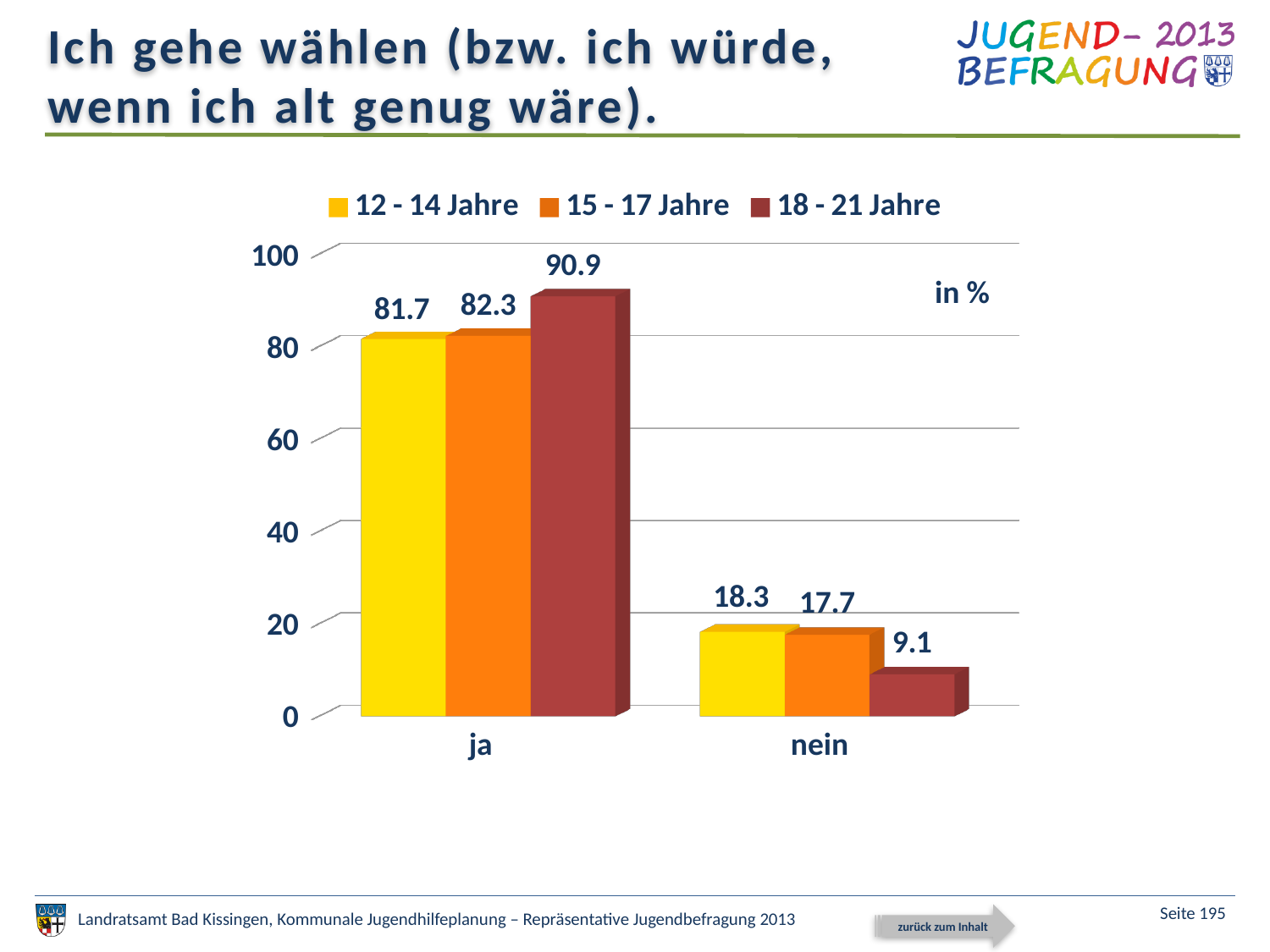
Which age group has the lowest value in the "nein" category? 18 - 21 Jahre What is the value for the 18 - 21 Jahre series in the "ja" category? 90.9 What is the difference between the 18 - 21 Jahre and 12 - 14 Jahre values in the "ja" category? 9.2 What is the value for the 15 - 17 Jahre series in the "ja" category? 82.3 How many series does the legend list? 3 Which age group has the highest value in the "ja" category? 18 - 21 Jahre What kind of chart is shown on the slide? bar chart Which is larger: the 12 - 14 Jahre value for "nein" or the 18 - 21 Jahre value for "nein"? 12 - 14 Jahre How many categories are shown on the x axis? 2 What unit is indicated for the values in the chart? in % What is the value for the 12 - 14 Jahre series in the "nein" category? 18.3 What is the difference between the 15 - 17 Jahre and 18 - 21 Jahre values in the "nein" category? 8.6